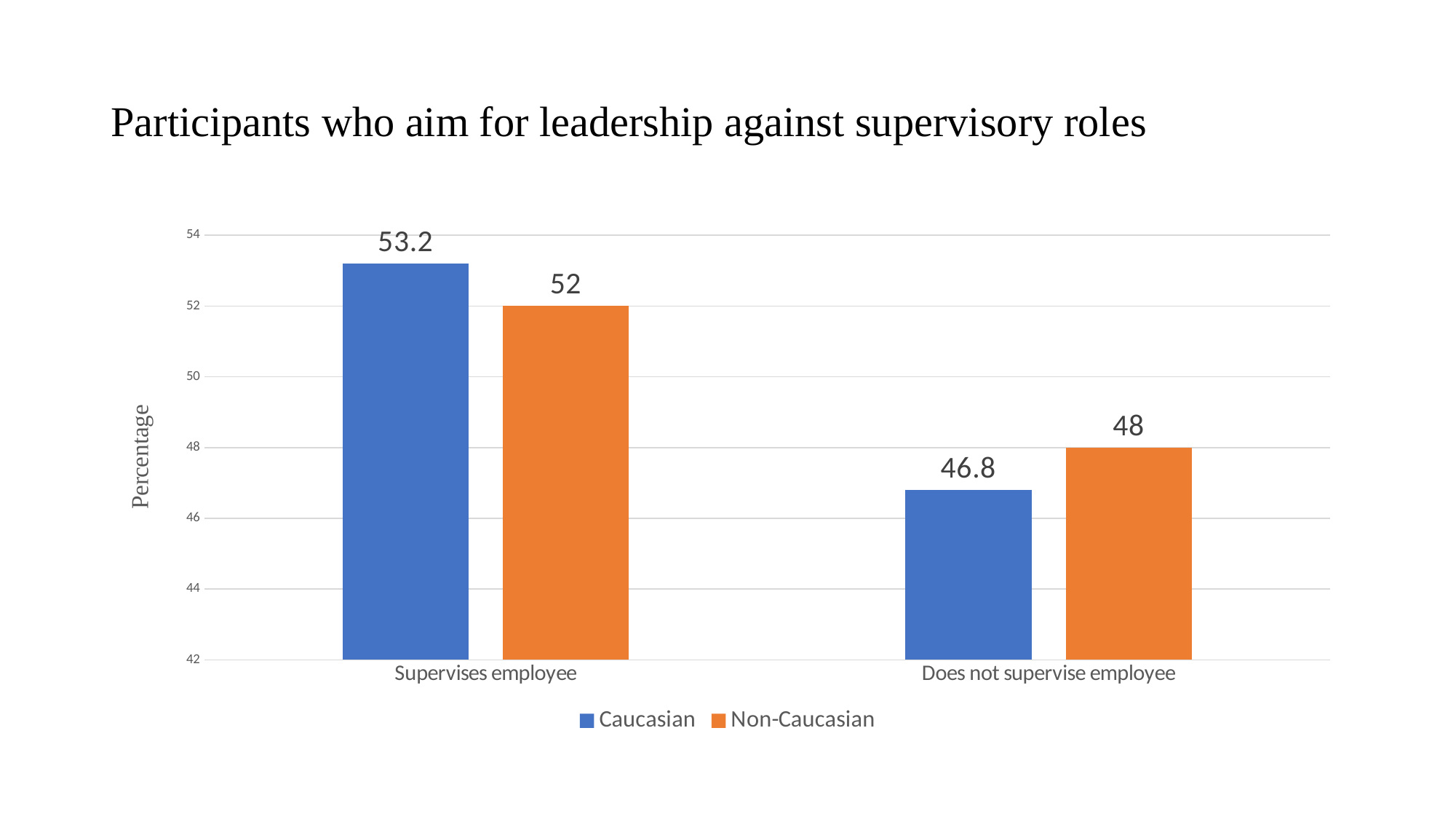
What is the difference between the Non-Caucasian and Caucasian values for 'Does not supervise employee'? 1.2 How many categories are shown on the x axis? 2 What type of chart is shown on the slide? Bar chart What is the value for Non-Caucasian participants who supervise employees? 52 What is the value for Caucasian participants who supervise employees? 53.2 Which bar has the highest value on the chart? Caucasian, Supervises employee Which bar has the lowest value on the chart? Caucasian, Does not supervise employee What is the value for Caucasian participants who do not supervise employees? 46.8 What is the difference between the Caucasian and Non-Caucasian values for 'Supervises employee'? 1.2 How many series does the legend list? 2 For 'Does not supervise employee', which series has the larger value, Caucasian or Non-Caucasian? Non-Caucasian What is the value for Non-Caucasian participants who do not supervise employees? 48